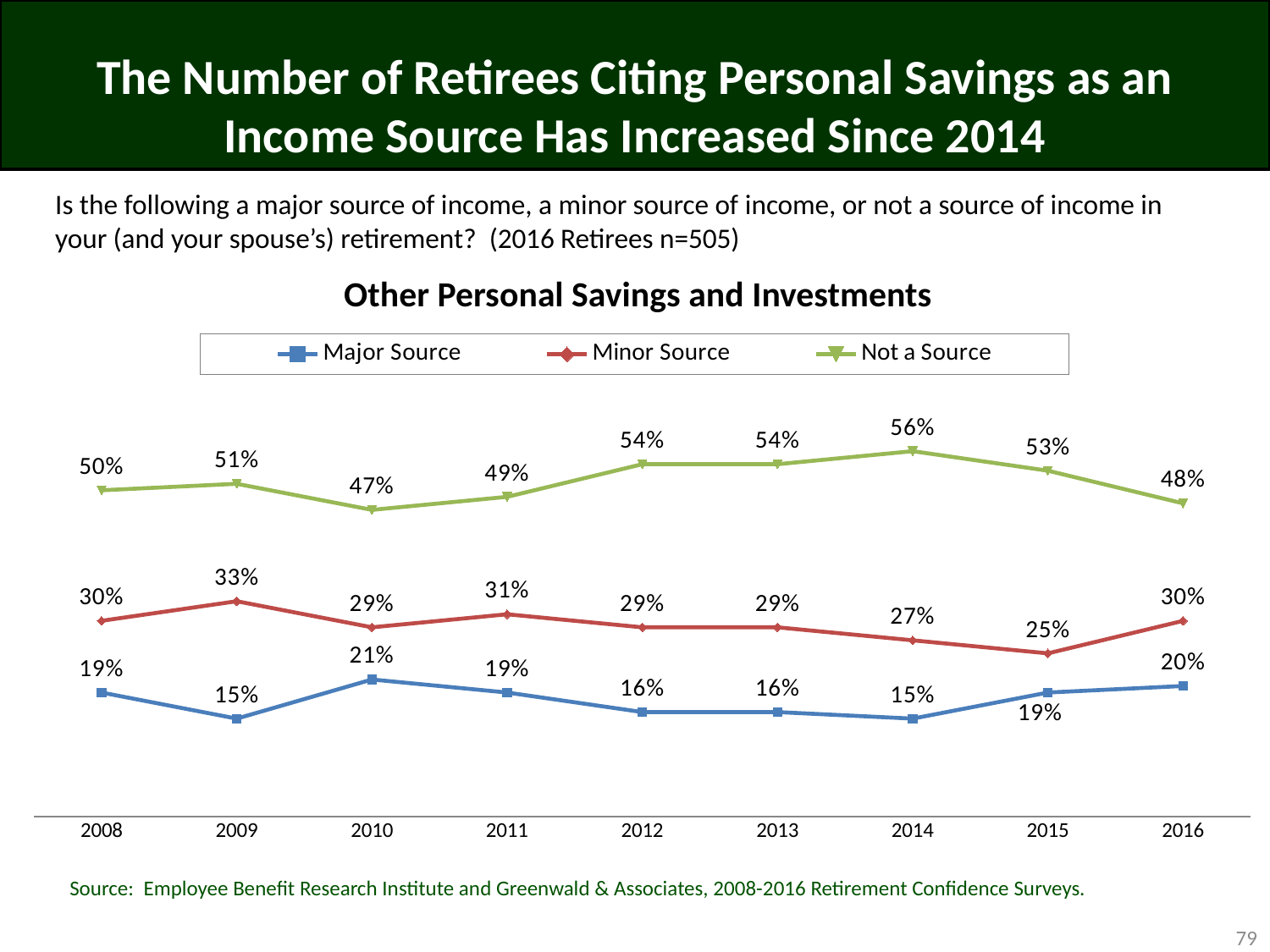
What is the difference between the Not a Source value and the Major Source value in 2016? 28% What is the title of the chart? Other Personal Savings and Investments How many series does the legend list? 3 What is the value for Minor Source in 2015? 25% Does the Major Source value rise or fall from 2014 to 2016? Rise What is the value for Not a Source in 2014? 56% In which year is the Not a Source value highest? 2014 What is the value for Major Source in 2010? 21% Which is larger in 2009: the Minor Source value or the Major Source value? Minor Source How many years are plotted along the x axis? 9 What kind of chart is shown on the slide? Line chart In which year is the Minor Source value lowest? 2015